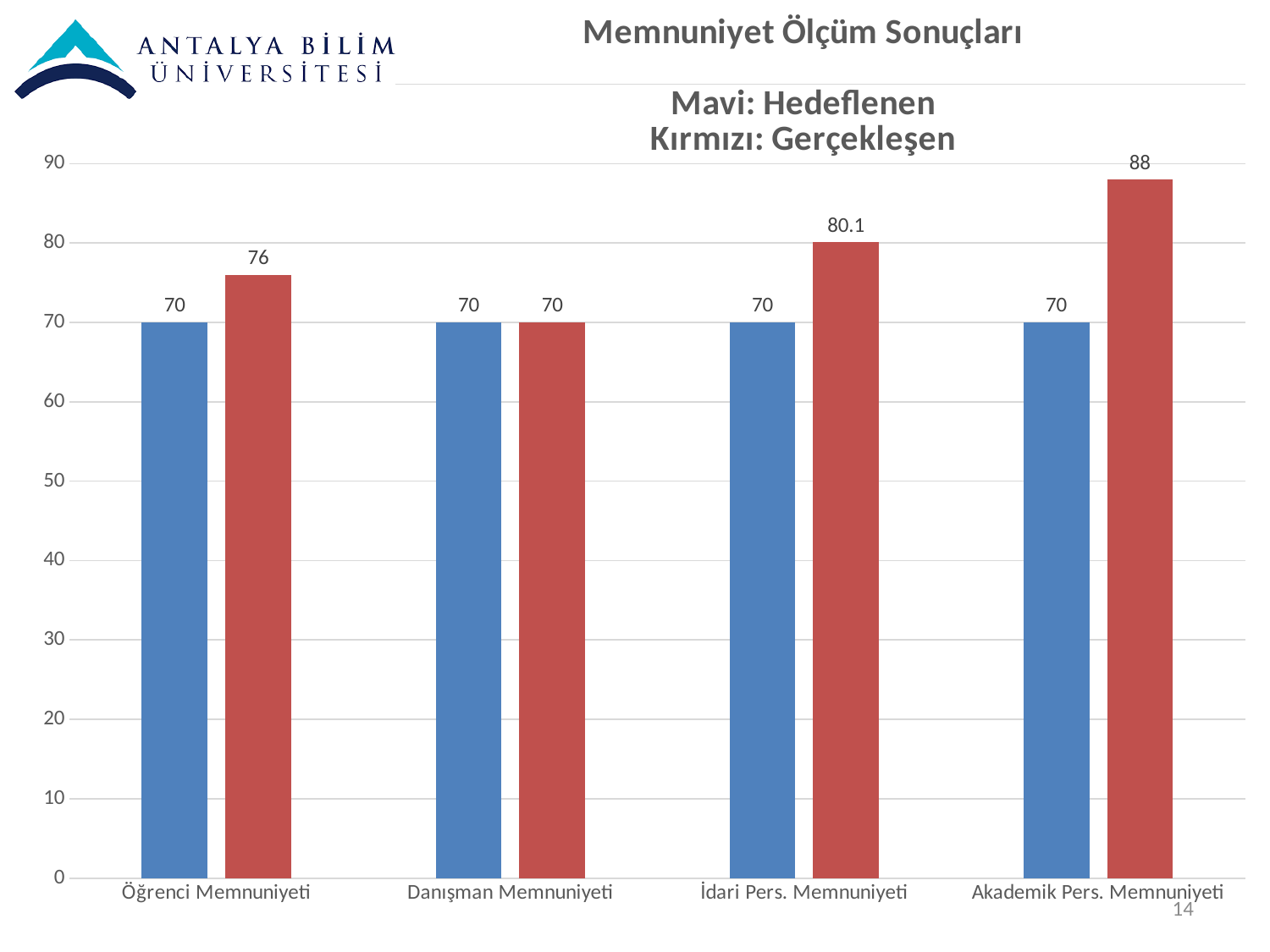
Which category has the lowest Gerçekleşen (red) value? Danışman Memnuniyeti Which category has the highest Gerçekleşen (red) value? Akademik Pers. Memnuniyeti What is the Gerçekleşen (red) value for İdari Pers. Memnuniyeti? 80.1 What is the difference between the Gerçekleşen values for İdari Pers. Memnuniyeti and Öğrenci Memnuniyeti? 4.1 According to the chart heading, what does the red colour represent? Gerçekleşen Which is larger: the Gerçekleşen value for Öğrenci Memnuniyeti or for İdari Pers. Memnuniyeti? İdari Pers. Memnuniyeti What is the Gerçekleşen (red) value for Öğrenci Memnuniyeti? 76 What kind of chart is shown on the slide? Bar chart What is the difference between the Gerçekleşen and Hedeflenen values for Akademik Pers. Memnuniyeti? 18 How many data series are plotted in the chart? 2 How many categories are shown on the x axis? 4 What is the Hedeflenen (blue) value for Akademik Pers. Memnuniyeti? 70